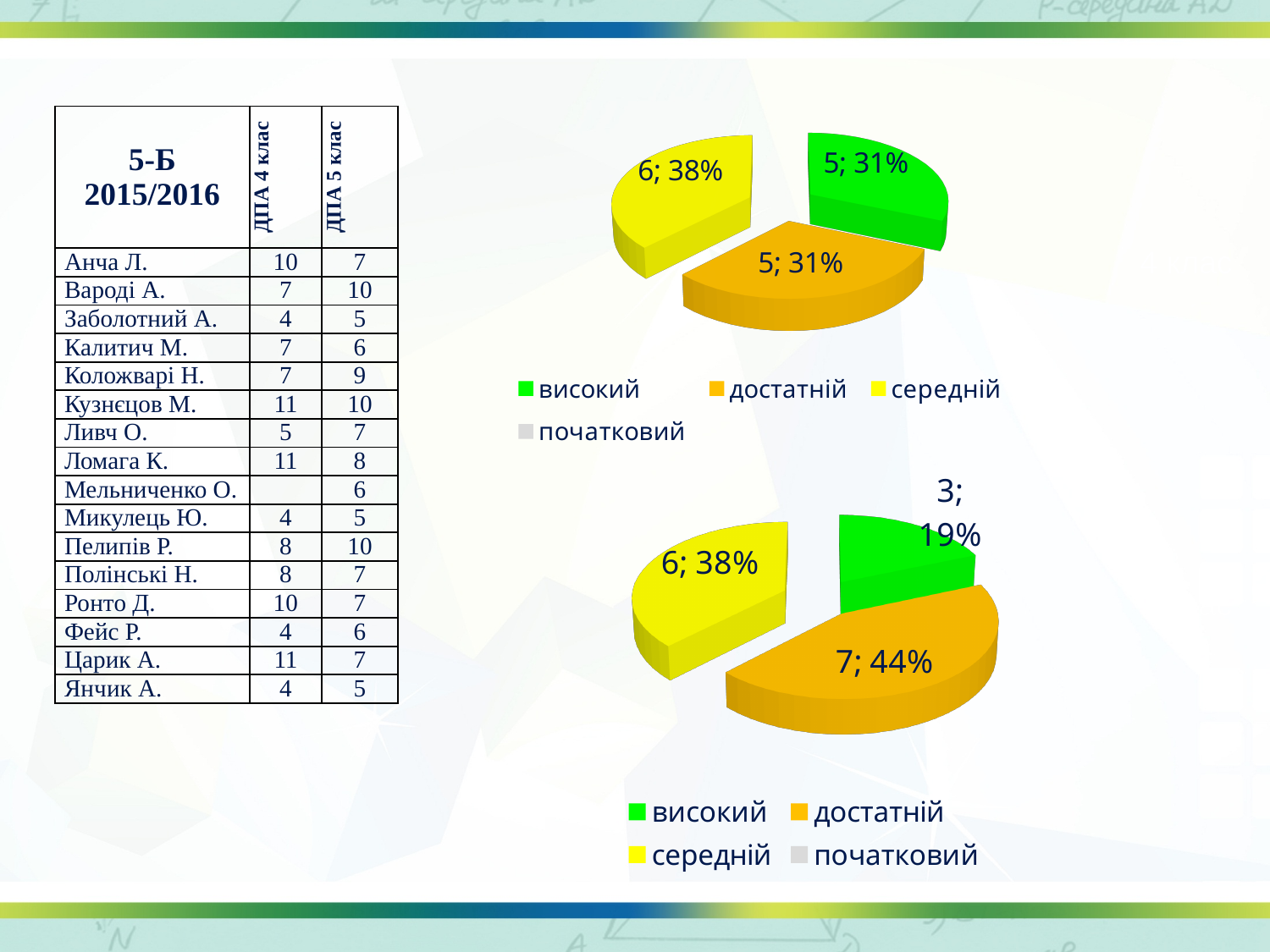
How many entries does the legend of the top pie chart list? 4 In the top pie chart, what colour is the достатній slice? orange In the bottom pie chart, which category has the largest slice? достатній In the top pie chart, what share does the високий slice have? 31% In the bottom pie chart, which category has the smallest slice? високий In the top pie chart, which category has the largest slice? середній In the top pie chart, what value and share are shown for the середній slice? 6; 38% In the bottom pie chart, what share does the високий slice have? 19% In the bottom pie chart, what value and share are shown for the достатній slice? 7; 44% In the bottom pie chart, what is the difference between the достатній count and the високий count? 4 In the bottom pie chart, which is larger, the достатній slice or the середній slice? достатній What type of chart is the bottom chart on the slide? pie chart